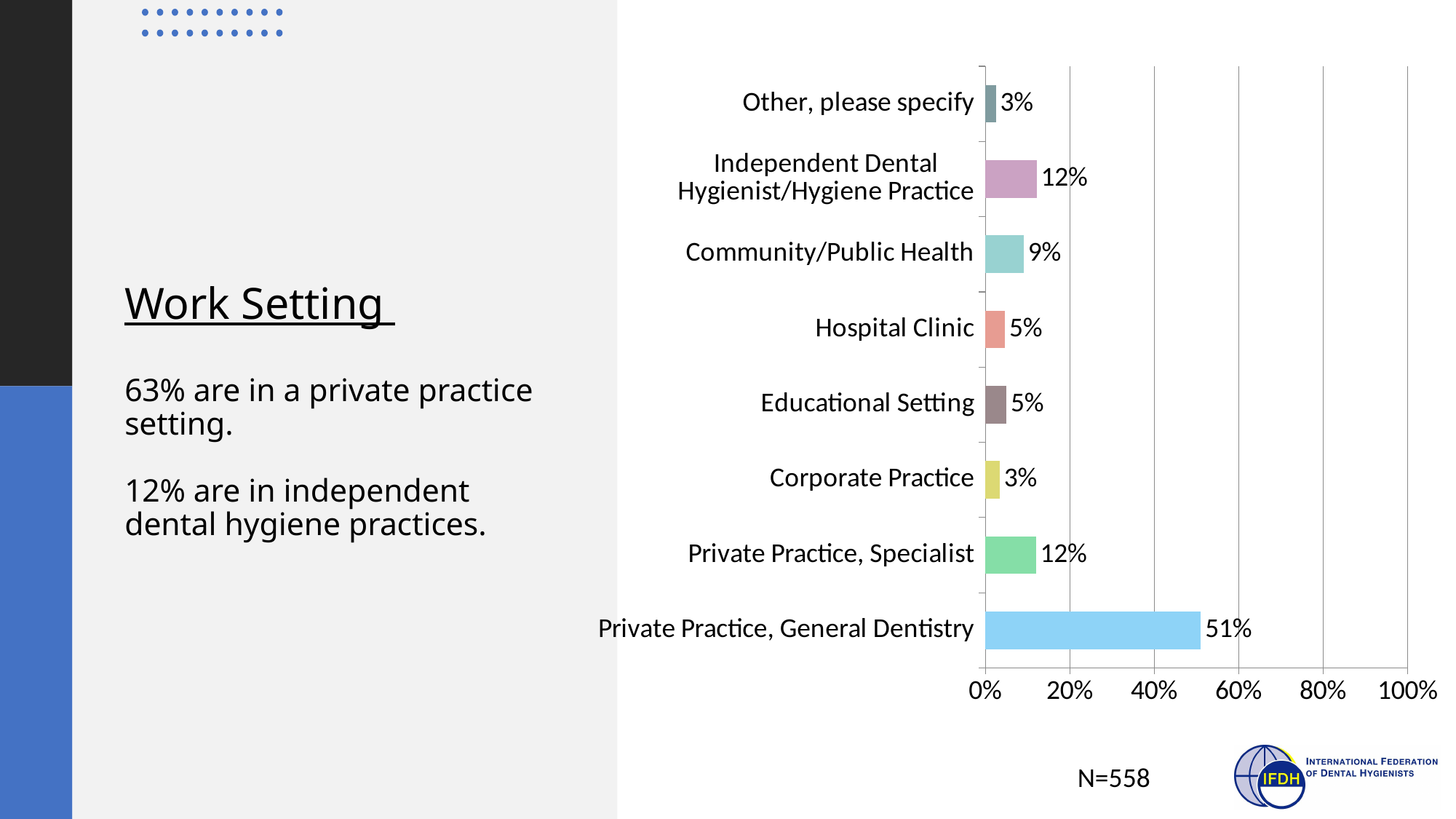
What is the difference between Private Practice, General Dentistry and Private Practice, Specialist? 39% What is the value for Hospital Clinic? 5% What kind of chart is shown on the slide? bar chart What is the sample size (N) shown below the chart? N=558 What is the value for Community/Public Health? 9% What is the value for Private Practice, General Dentistry? 51% What is the value for Independent Dental Hygienist/Hygiene Practice? 12% Which is larger, Community/Public Health or Hospital Clinic? Community/Public Health How many categories are shown in the chart? 8 Which category has the highest value? Private Practice, General Dentistry What is the difference between Community/Public Health and Corporate Practice? 6% Is the value for Private Practice, General Dentistry greater or less than 40%? greater